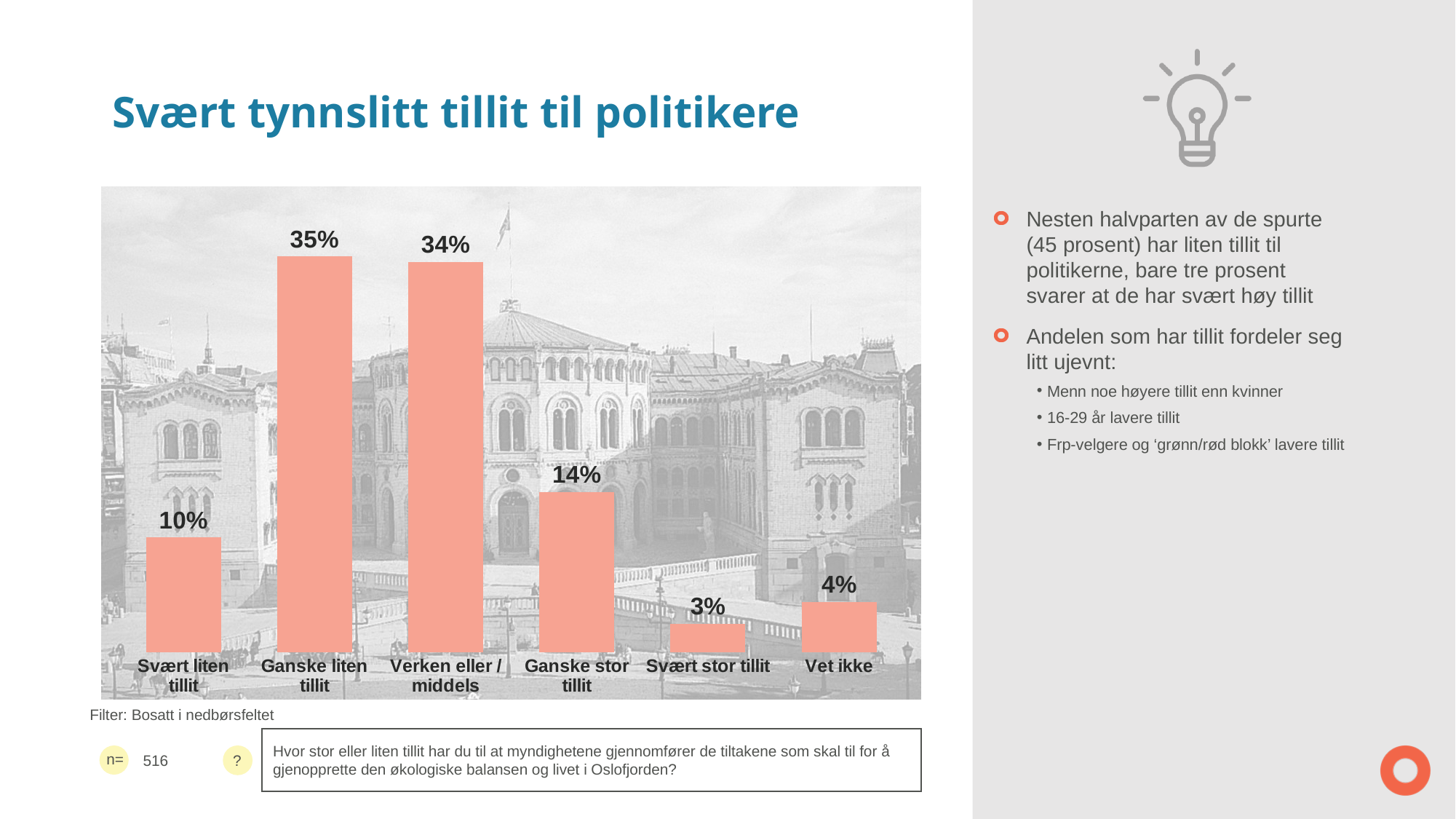
What is the value for 'Ganske liten tillit'? 35% What is the difference between 'Ganske liten tillit' and 'Ganske stor tillit'? 21% How many categories are shown in the chart? 6 Which is larger, 'Svært liten tillit' or 'Ganske stor tillit'? Ganske stor tillit What is the sample size (n) shown below the chart? 516 What is the value for 'Ganske stor tillit'? 14% What is the value for 'Svært stor tillit'? 3% Which category has the highest value? Ganske liten tillit Which category has the lowest value? Svært stor tillit What is the value for 'Vet ikke'? 4% What kind of chart is shown on the slide? Bar chart What is the combined value of 'Svært liten tillit' and 'Ganske liten tillit'? 45%